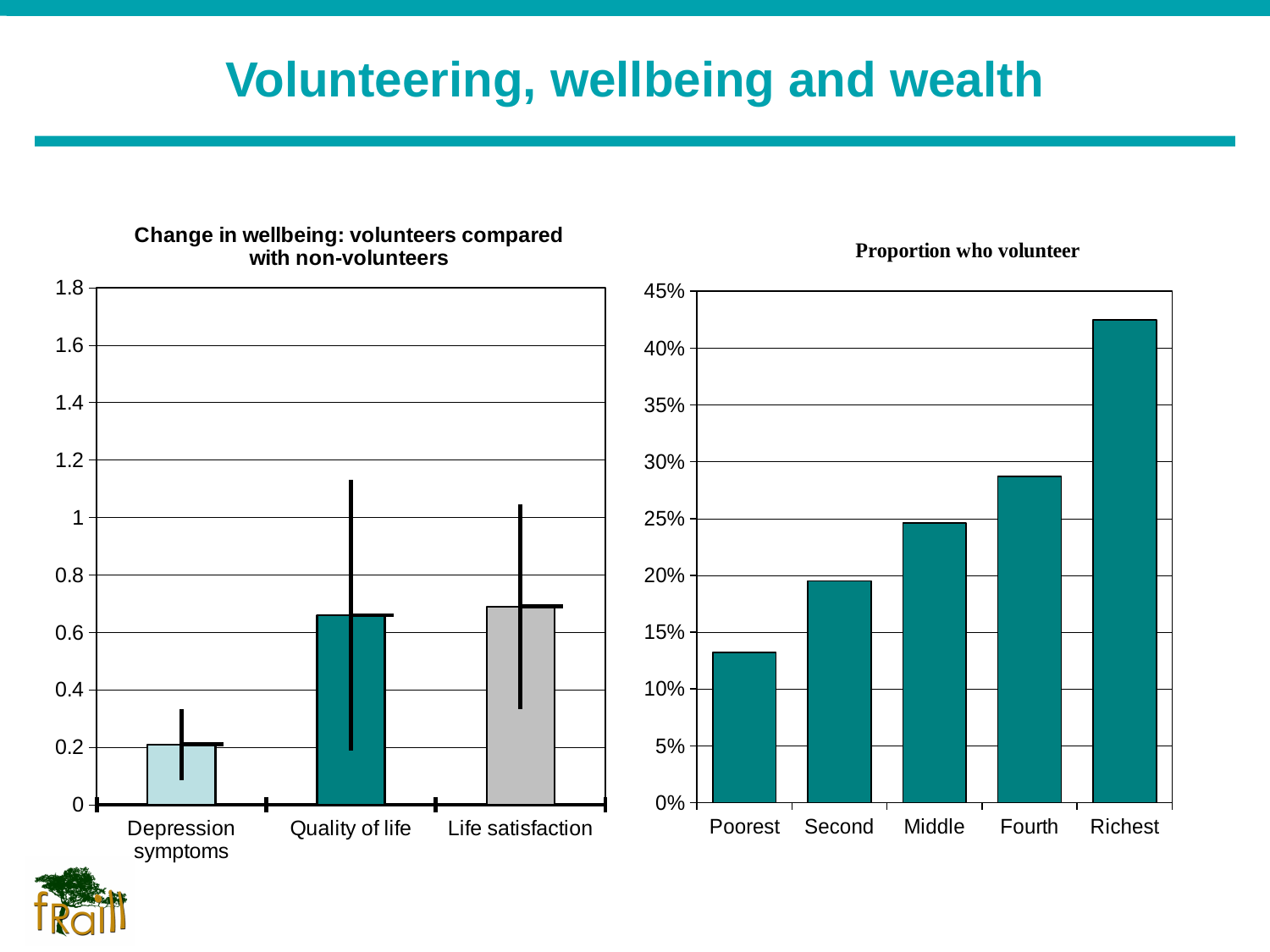
On the "Proportion who volunteer" chart, is the value for Poorest greater or less than 15%? less On the "Proportion who volunteer" chart, which wealth group has the lowest proportion who volunteer? Poorest On the "Proportion who volunteer" chart, which wealth group has the highest proportion who volunteer? Richest On the "Proportion who volunteer" chart, is the value for Richest greater or less than 40%? greater On the "Proportion who volunteer" chart, which is larger, the value for Middle or the value for Fourth? Fourth What is the title of the chart on the left of the slide? Change in wellbeing: volunteers compared with non-volunteers How many categories are shown on the "Proportion who volunteer" chart? 5 On the "Change in wellbeing: volunteers compared with non-volunteers" chart, which category has the lowest bar? Depression symptoms What kind of chart is the "Proportion who volunteer" chart? bar chart On the "Proportion who volunteer" chart, do the values rise or fall from Poorest to Richest? rise On the "Change in wellbeing: volunteers compared with non-volunteers" chart, is the value for Quality of life greater or less than 0.4? greater How many categories are shown on the "Change in wellbeing: volunteers compared with non-volunteers" chart? 3